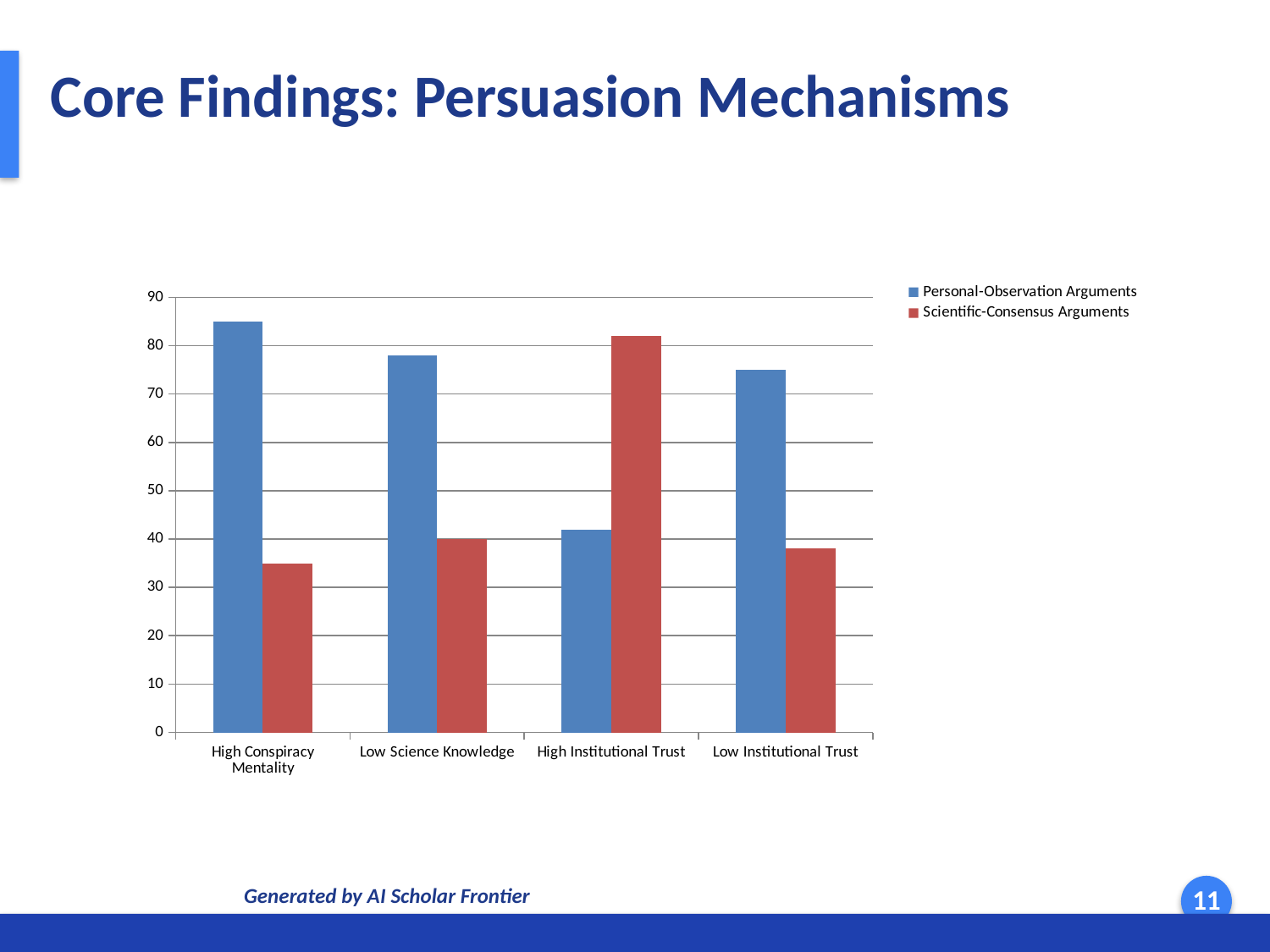
Which category has the highest value for Personal-Observation Arguments? High Conspiracy Mentality How many categories are shown on the x axis? 4 Which category has the highest value for Scientific-Consensus Arguments? High Institutional Trust How many series does the legend list? 2 Which colour represents Scientific-Consensus Arguments in the legend? red For Low Science Knowledge, which series has the larger value: Personal-Observation Arguments or Scientific-Consensus Arguments? Personal-Observation Arguments Is the value for Personal-Observation Arguments at High Institutional Trust greater or less than 50? less Is the value for Personal-Observation Arguments at High Conspiracy Mentality greater or less than 80? greater For High Institutional Trust, which series has the larger value: Personal-Observation Arguments or Scientific-Consensus Arguments? Scientific-Consensus Arguments Which category has the lowest value for Personal-Observation Arguments? High Institutional Trust What kind of chart is shown on the slide? bar chart Is the value for Scientific-Consensus Arguments at High Conspiracy Mentality greater or less than 30? greater